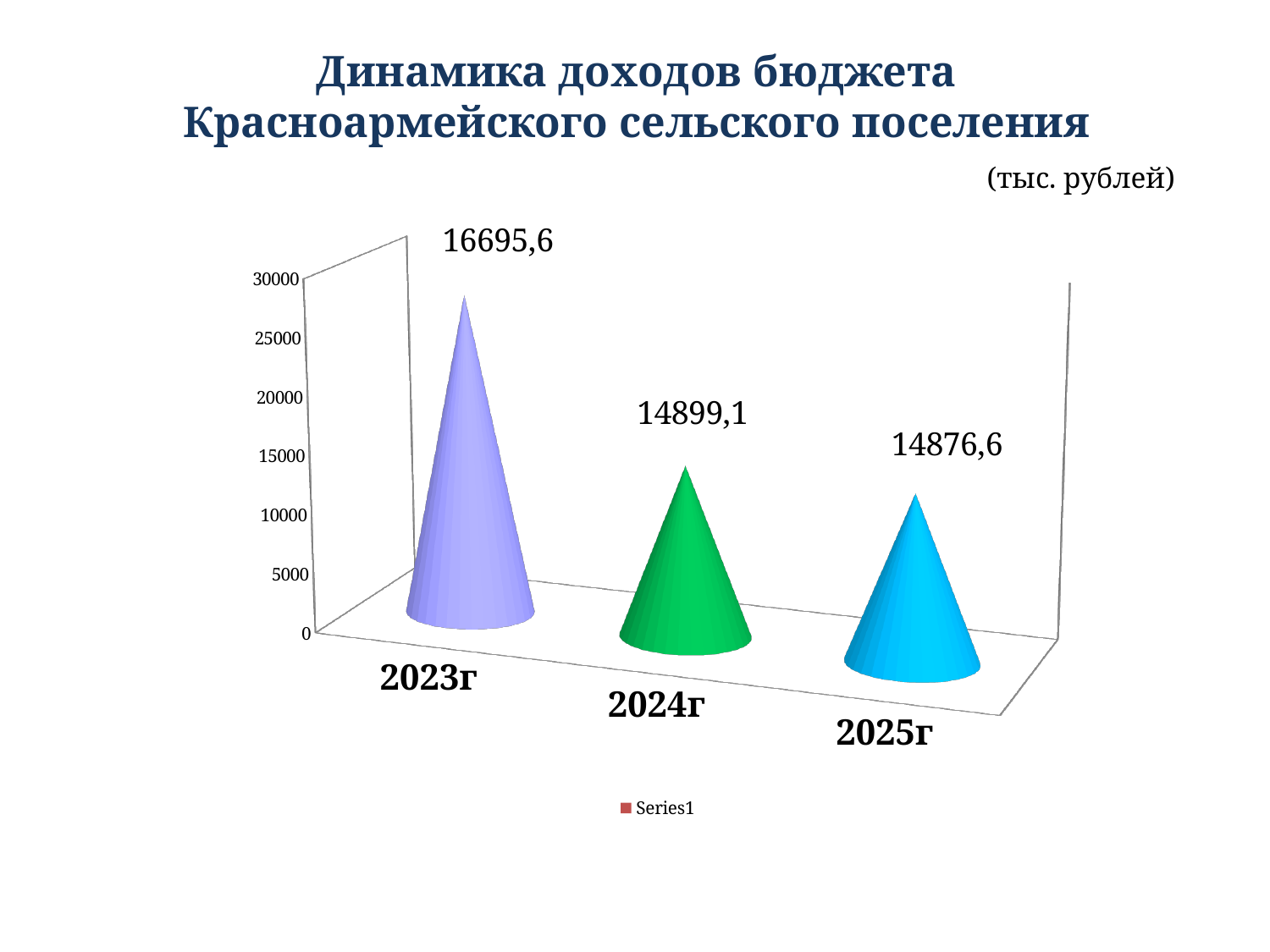
What is the difference between the values for 2023г and 2024г? 1796,5 Which year has the lowest value? 2025г Which is larger, the value for 2023г or the value for 2025г? 2023г Do the values rise or fall from 2023г to 2025г? fall What is the value for 2025г? 14876,6 How many years are shown on the x axis? 3 What is the value for 2024г? 14899,1 What is the value for 2023г? 16695,6 What is the difference between the values for 2024г and 2025г? 22,5 What unit is stated for the chart values? тыс. рублей Is the value for 2023г greater or less than 15000? greater Which year has the highest value? 2023г